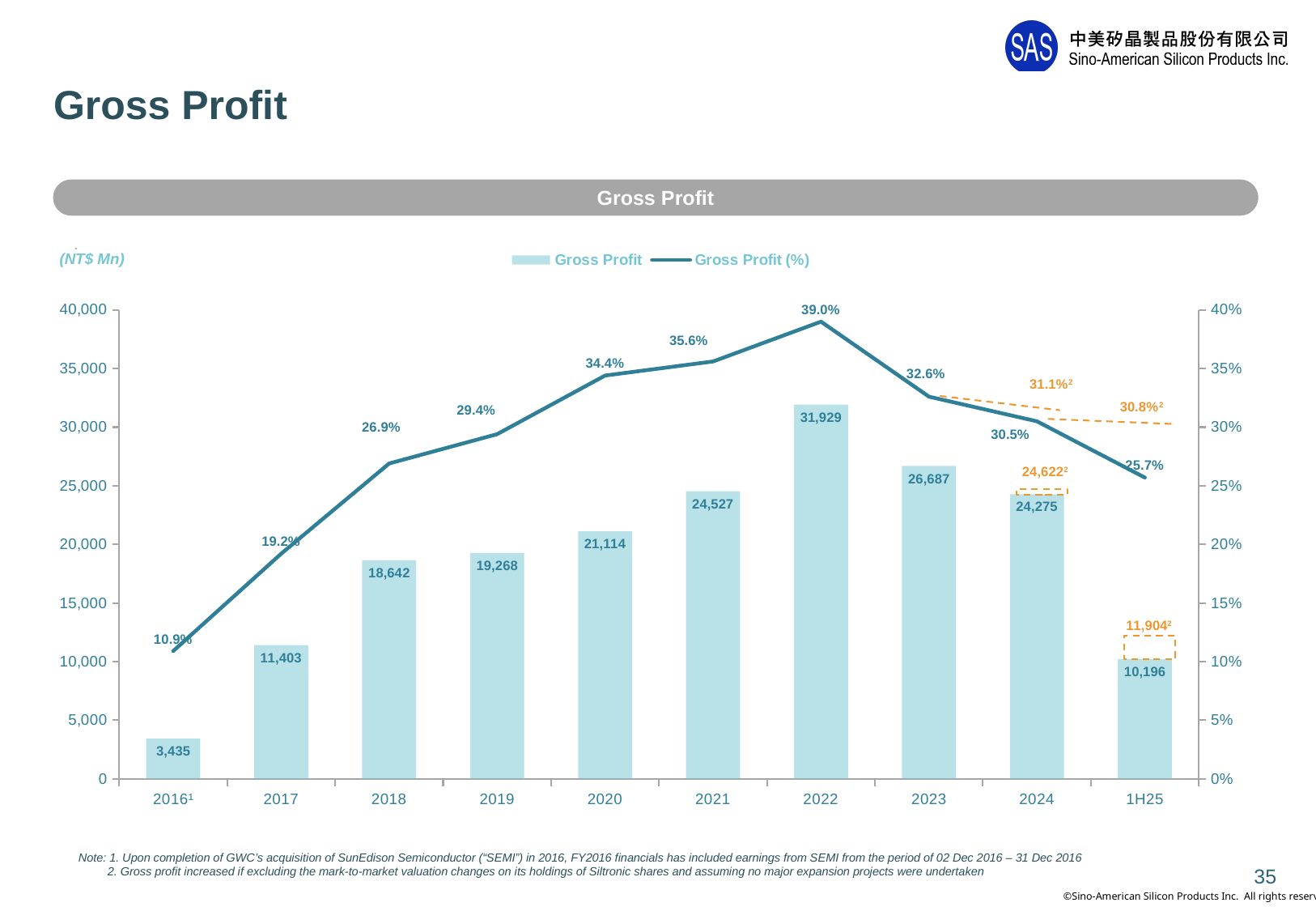
How many series does the legend list? 2 Which is larger, the Gross Profit for 2018 or for 2019? 2019 How many categories are shown on the x axis? 10 What is the Gross Profit value for 1H25? 10,196 Which category has the lowest Gross Profit bar? 2016 Does the Gross Profit (%) line rise or fall from 2022 to 1H25? fall What is the Gross Profit value for 2022? 31,929 What is the difference in Gross Profit between 2023 and 2024? 2,412 What is the Gross Profit (%) for 2019? 29.4% Which year has the highest Gross Profit (%)? 2022 What unit is stated for the Gross Profit bars? NT$ Mn Is the Gross Profit value for 2021 greater or less than 25,000? less